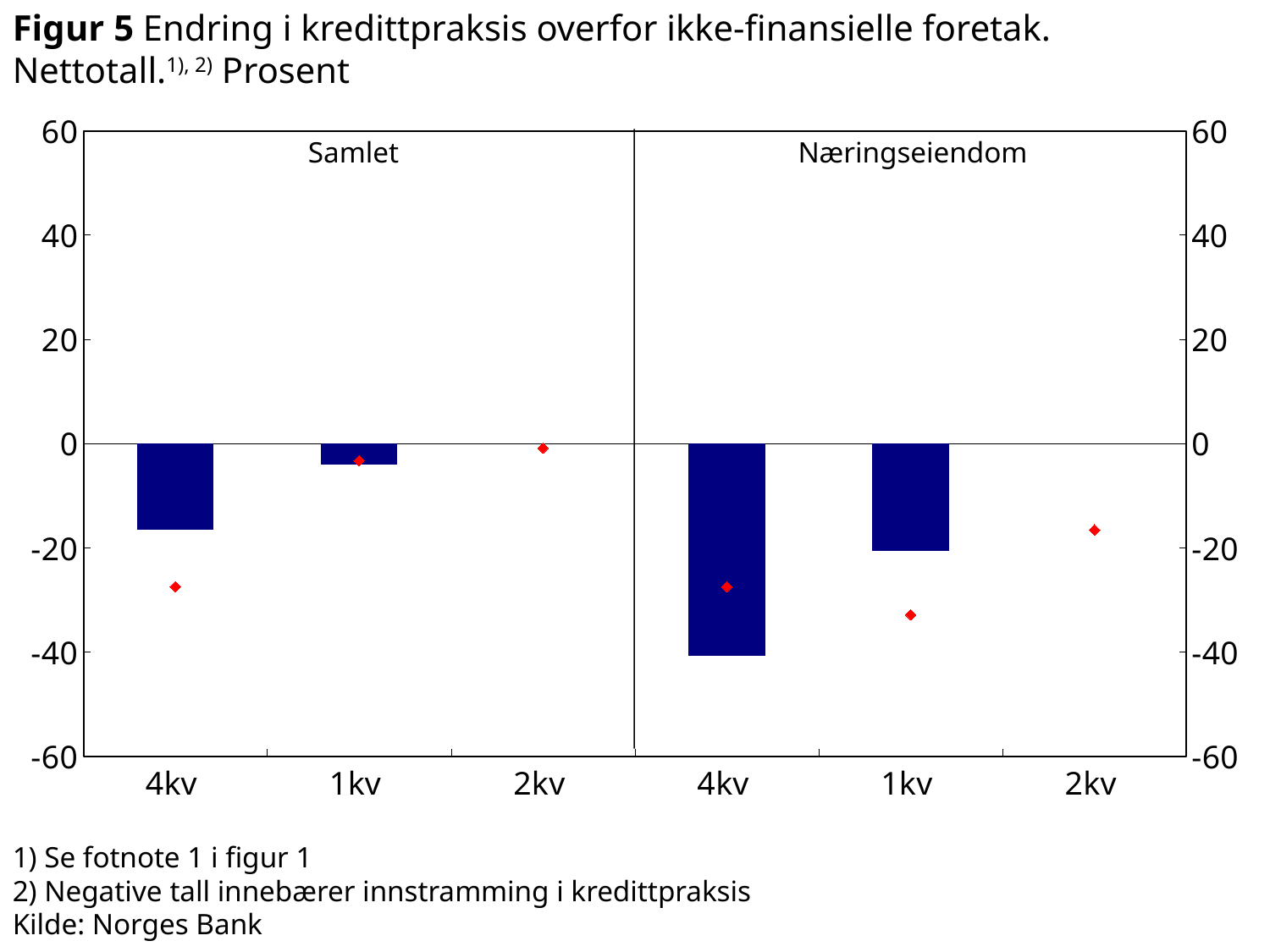
Is the value of the 4kv bar in the Næringseiendom panel greater or less than -20? less What are the titles of the two panels in the chart? Samlet and Næringseiendom In the Samlet panel, which quarter has the lowest (most negative) bar? 4kv Which bar is lower (more negative): the 4kv bar in the Samlet panel or the 4kv bar in the Næringseiendom panel? 4kv in Næringseiendom How many quarters are shown on the x axis across both panels combined? 6 What kind of chart is shown in Figur 5? bar chart Is the value of the 1kv bar in the Næringseiendom panel greater or less than -40? greater How many quarters are shown on the x axis in the Samlet panel? 3 Is the value of the 4kv bar in the Samlet panel greater or less than -20? greater In the Næringseiendom panel, which quarter has the lowest (most negative) bar? 4kv What source is given for the chart? Norges Bank In the Samlet panel, do the bar values rise or fall from 4kv to 2kv? rise